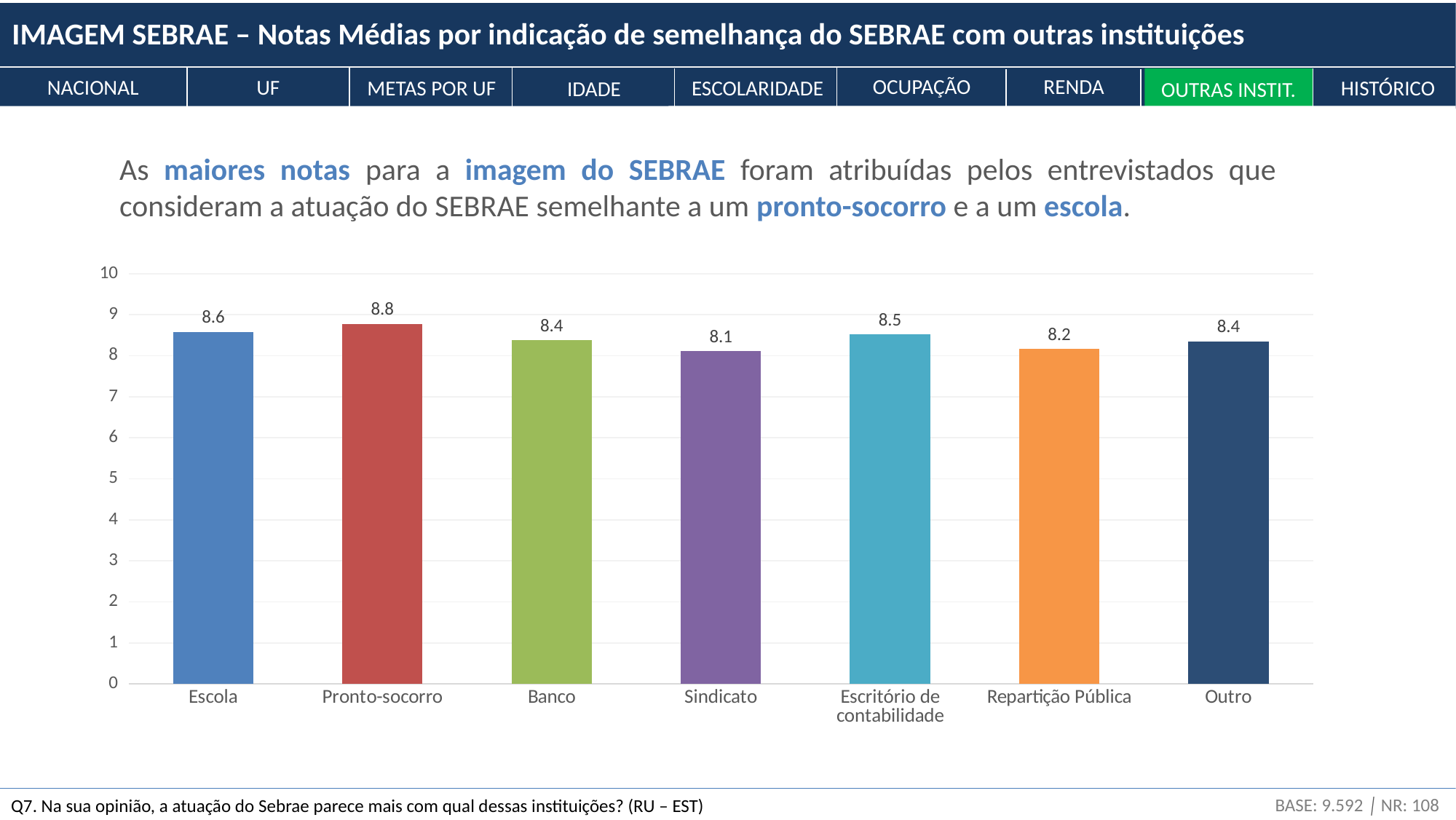
What is the difference between the scores for Pronto-socorro and Sindicato? 0.7 What kind of chart is shown on the slide? Bar chart What is the average score for Repartição Pública? 8.2 What is the average score for Escritório de contabilidade? 8.5 Which category has the lowest average score? Sindicato How many categories are shown on the x axis of the chart? 7 Which has a higher score, Escola or Banco? Escola What is the average score for Sindicato? 8.1 Which category has the highest average score? Pronto-socorro What is the average score for Pronto-socorro? 8.8 What is the difference between the scores for Escola and Repartição Pública? 0.4 What is the maximum value shown on the vertical axis of the chart? 10